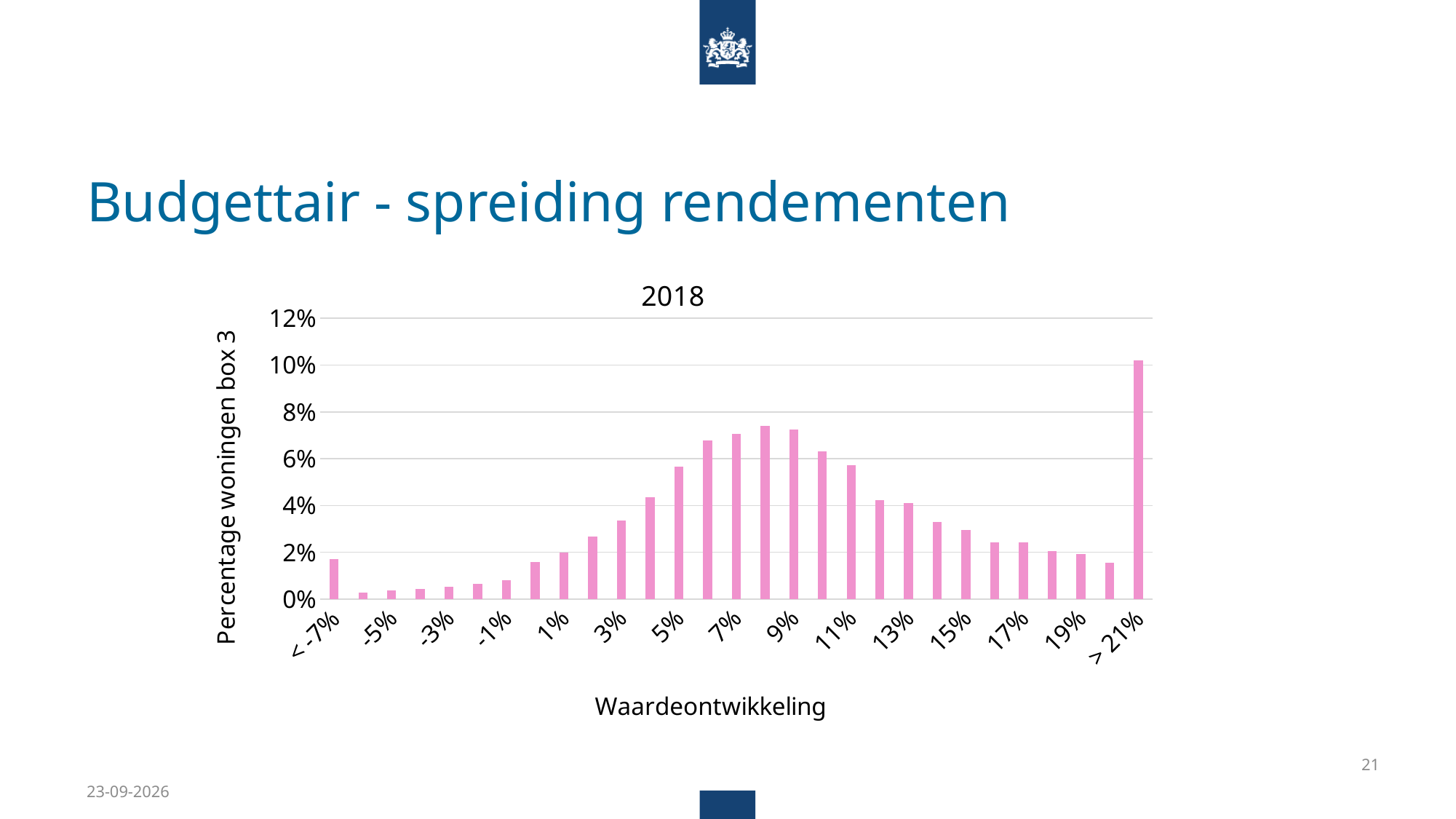
Do the values rise or fall from 11% to 19% along the x axis? fall Is the value for 15% greater or less than 4%? less Which category has the highest value? > 21% What kind of chart is shown on the slide? bar chart Is the value for 7% greater or less than 6%? greater Which is larger, the value for 5% or the value for 13%? 5% What is the label of the vertical axis? Percentage woningen box 3 What is the title of the chart? 2018 Is the value for > 21% greater or less than 8%? greater Which is larger, the value for 7% or the value for 11%? 7%